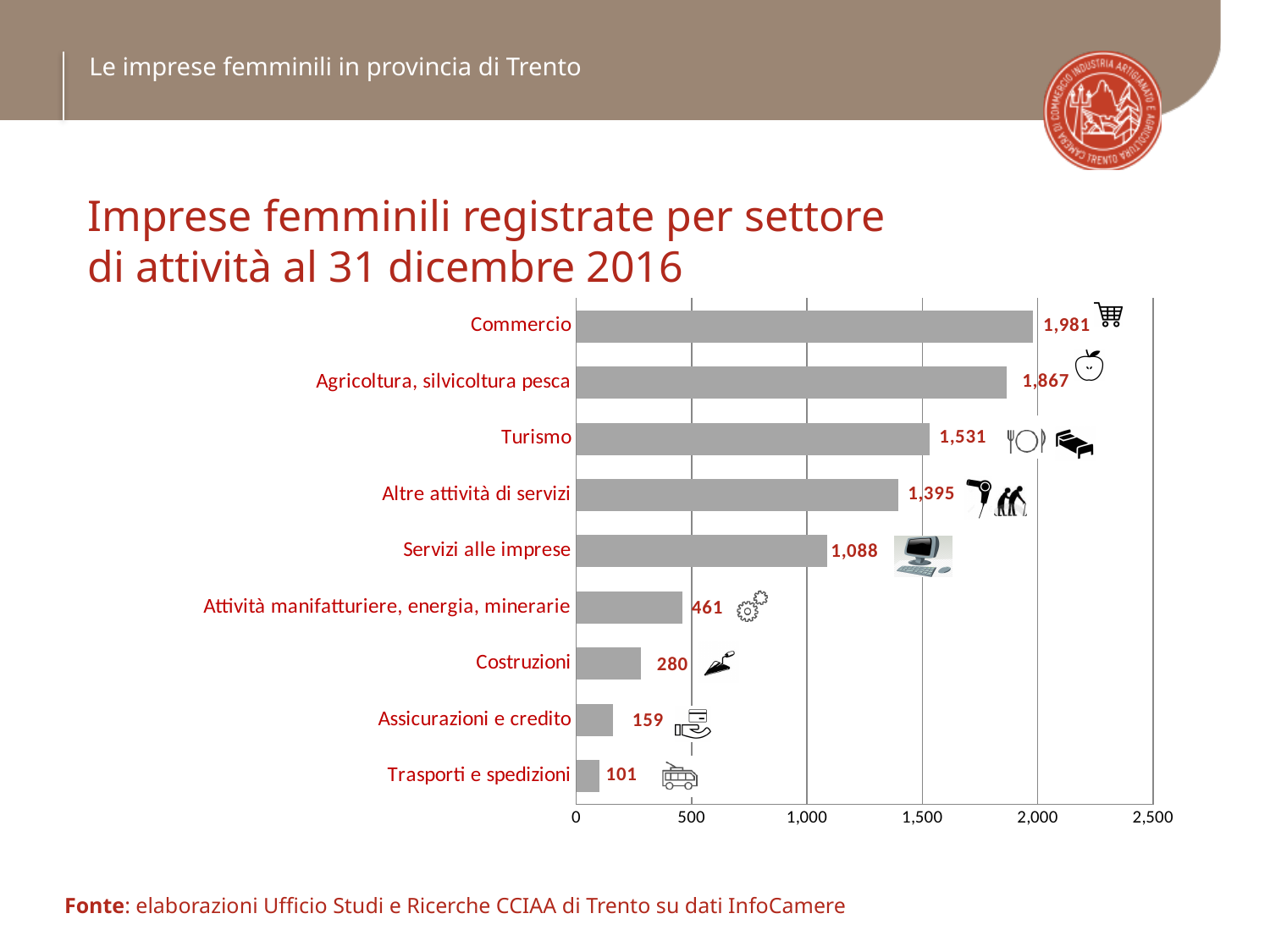
What is the difference between the values for Commercio and Agricoltura, silvicoltura pesca? 114 How many categories are shown in the chart? 9 Is the value for Turismo greater or less than 1,500? greater What is the maximum value shown on the horizontal axis? 2,500 What is the value for Turismo? 1,531 What is the difference between the values for Servizi alle imprese and Attività manifatturiere, energia, minerarie? 627 Which category has the lowest value? Trasporti e spedizioni What is the value for Costruzioni? 280 What is the value for Commercio? 1,981 Which category has the highest value? Commercio What kind of chart is shown on the slide? bar chart Which is larger, the value for Altre attività di servizi or the value for Servizi alle imprese? Altre attività di servizi